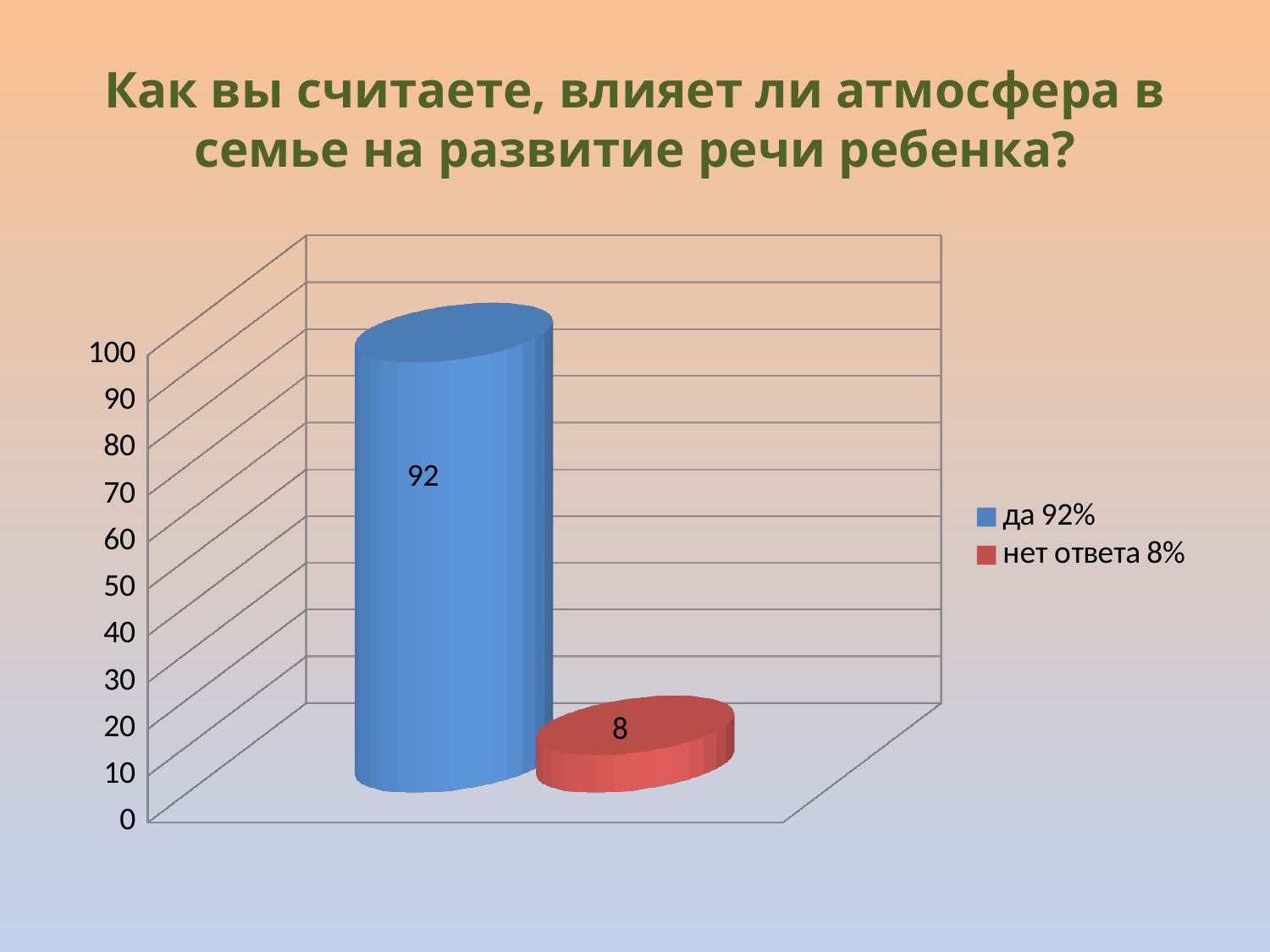
Which series has the lowest value? нет ответа 8% What is the value shown for "да 92%"? 92 Which is larger, the value for "да 92%" or the value for "нет ответа 8%"? да 92% What is the total of the two values plotted on the chart? 100 Is the value for "нет ответа 8%" greater or less than 20? less What colour is the bar for "нет ответа 8%"? red What kind of chart is shown on the slide? bar chart Which series has the highest value? да 92% How many series does the legend list? 2 What is the difference between the values for "да 92%" and "нет ответа 8%"? 84 Is the value for "да 92%" greater or less than 50? greater What is the value shown for "нет ответа 8%"? 8